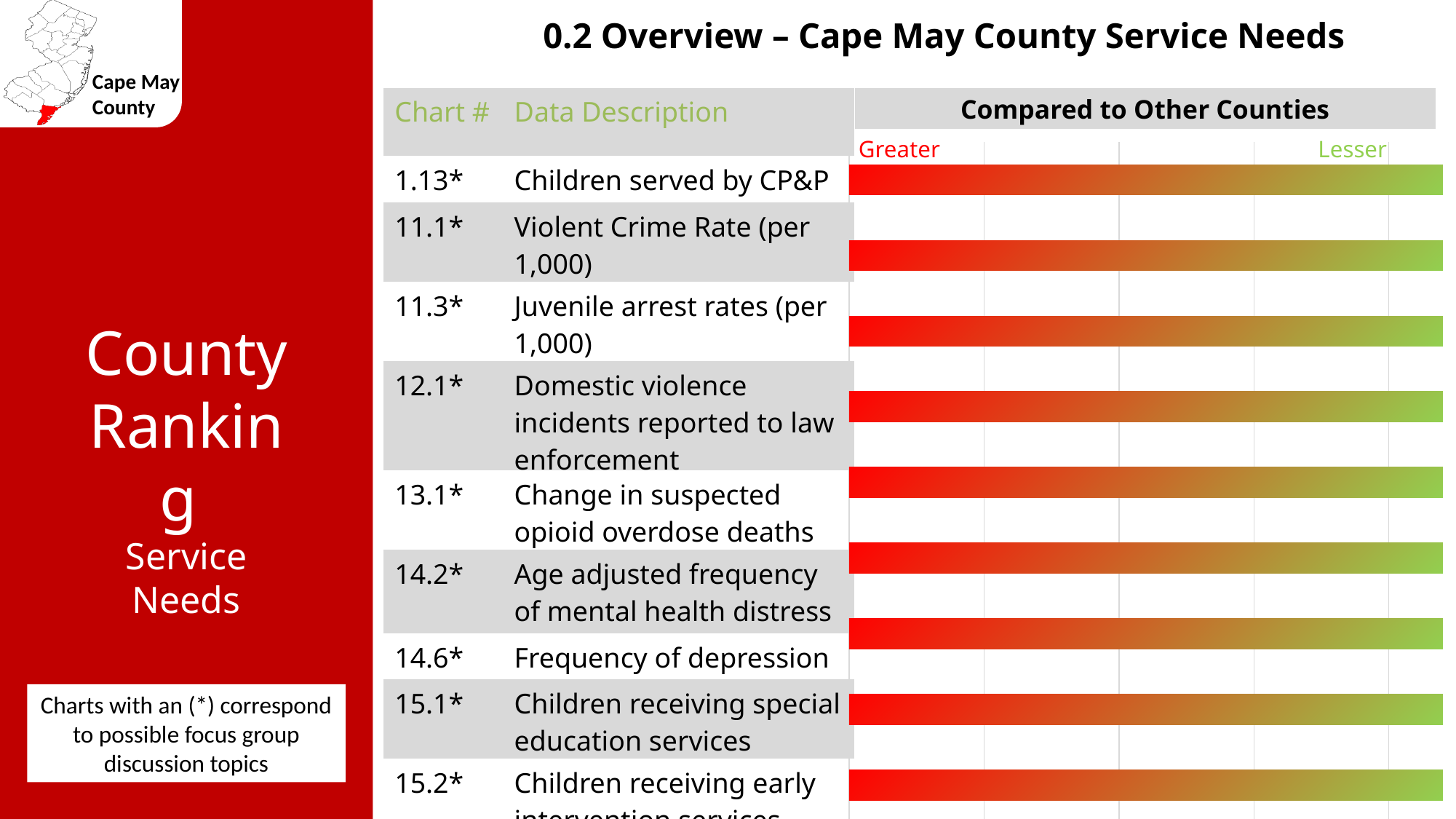
Which chart number is listed for 'Children served by CP&P'? 1.13* Which data description is listed for chart number 14.6*? Frequency of depression Which chart number is listed for 'Violent Crime Rate (per 1,000)'? 11.1* What label appears at the right end of the 'Compared to Other Counties' scale? Lesser What label appears at the left end of the 'Compared to Other Counties' scale? Greater How many data descriptions (rows) are listed in the Cape May County Service Needs table? 9